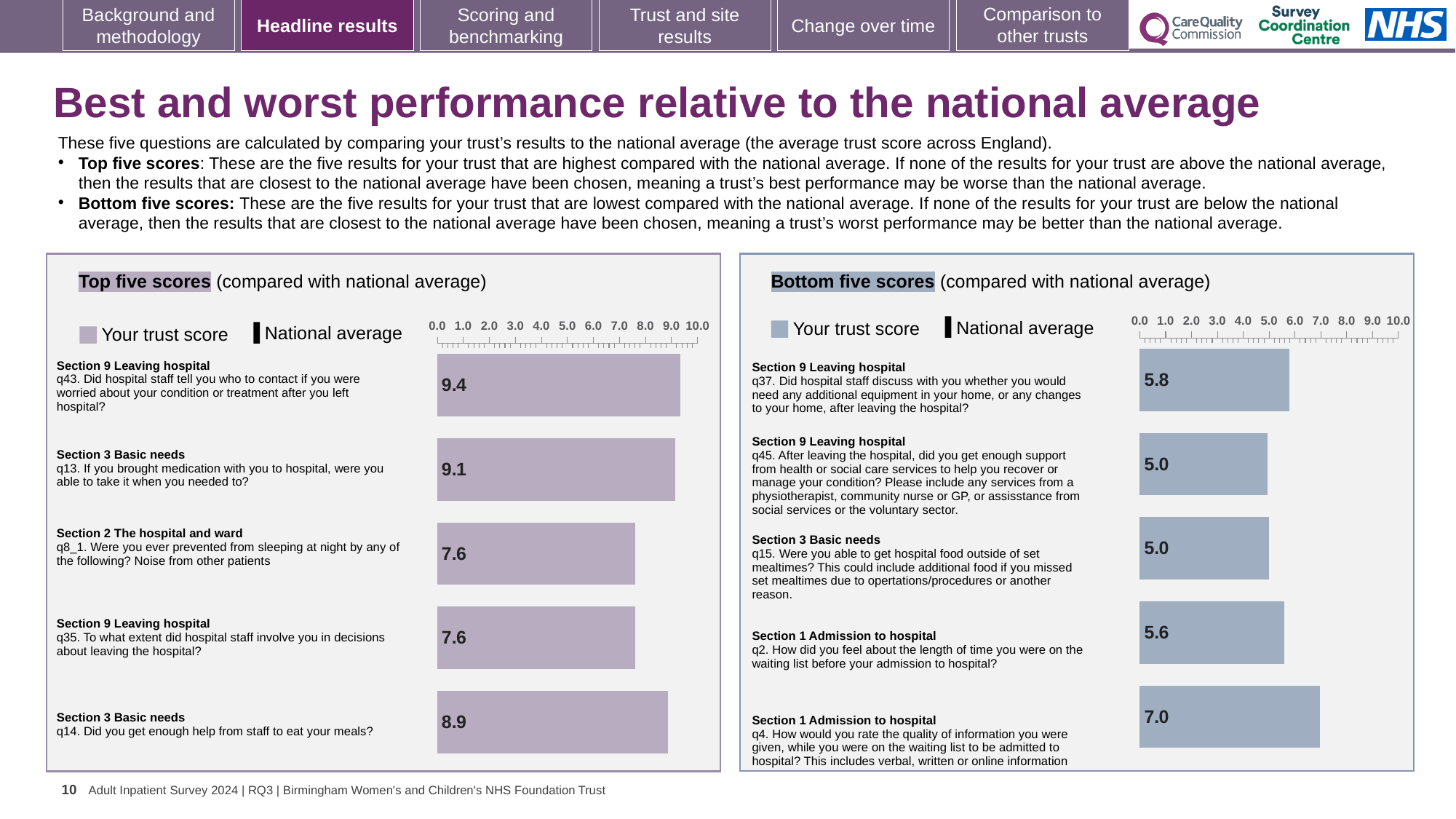
In the Bottom five scores chart, what is the difference between the trust scores for q4 and q2? 1.4 In the Top five scores chart, what is the difference between the trust scores for q43 and q13? 0.3 In the Top five scores chart, which question has the highest trust score? q43 In the Bottom five scores chart, which question has the highest trust score? q4 In the Bottom five scores chart, what is the trust score for q37 (Did hospital staff discuss with you whether you would need any additional equipment in your home, or any changes to your home, after leaving the hospital?)? 5.8 How many series does the legend of the Bottom five scores chart list? 2 What kind of chart is used in the Top five scores panel? Bar chart In the Bottom five scores chart, what is the trust score for q4 (How would you rate the quality of information you were given, while you were on the waiting list to be admitted to hospital?)? 7.0 In the Top five scores chart, what is the trust score for q14 (Did you get enough help from staff to eat your meals?)? 8.9 In the Bottom five scores chart, which is larger: the trust score for q37 or for q2? q37 In the Top five scores chart, what is the trust score for q43 (Did hospital staff tell you who to contact if you were worried about your condition or treatment after you left hospital?)? 9.4 In the Top five scores chart, how many questions are plotted? 5